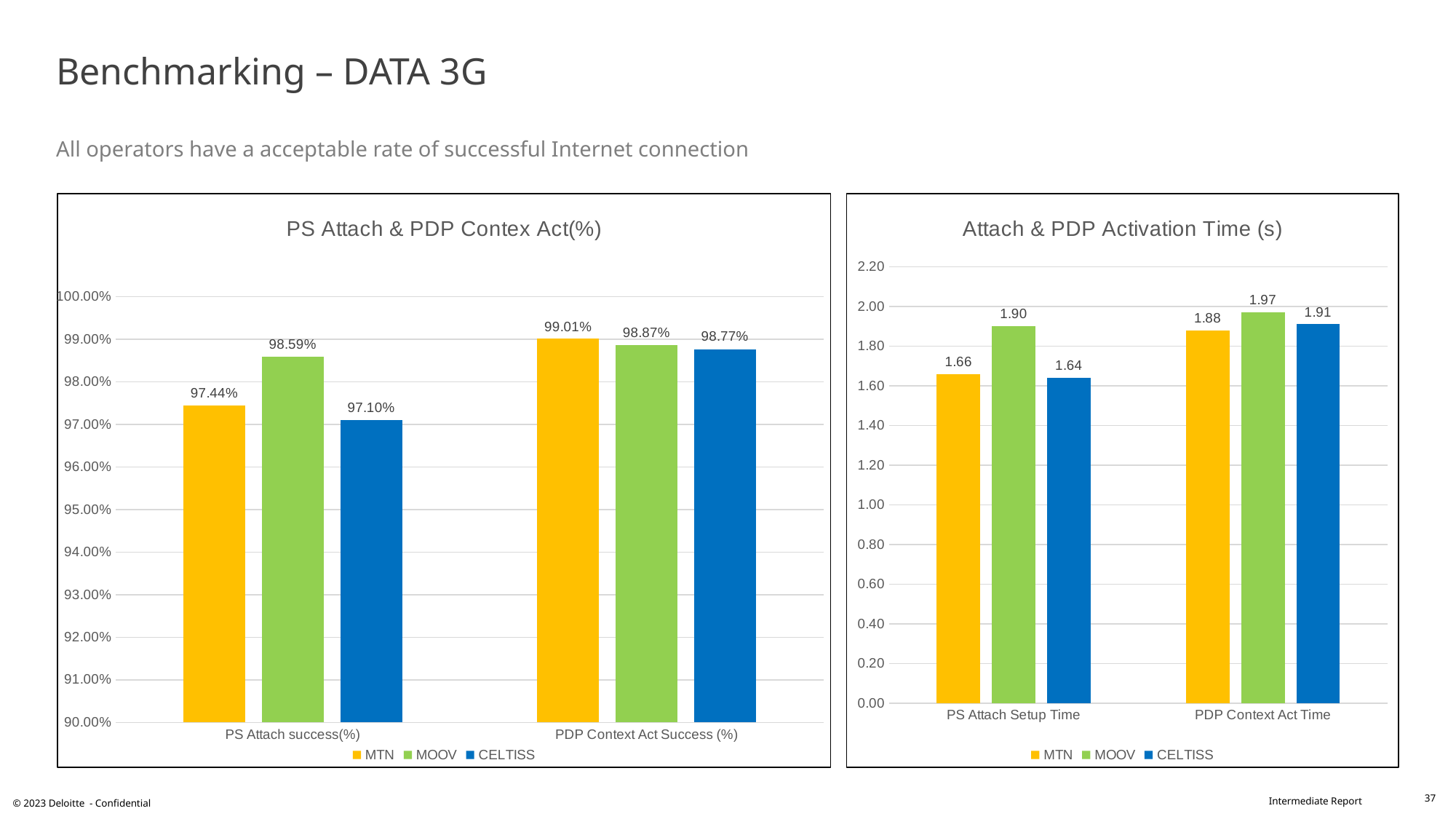
In the 'PS Attach & PDP Contex Act(%)' chart, which operator has the lowest PS Attach success rate? CELTISS In the 'Attach & PDP Activation Time (s)' chart, which operator has the lowest PS Attach Setup Time? CELTISS In the 'Attach & PDP Activation Time (s)' chart, what is the PS Attach Setup Time for MOOV? 1.90 In the 'PS Attach & PDP Contex Act(%)' chart, what is the difference between MOOV's and CELTISS's PS Attach success rates? 1.49% In the 'Attach & PDP Activation Time (s)' chart, what is the difference between MOOV's and MTN's PDP Context Act Time? 0.09 In the 'PS Attach & PDP Contex Act(%)' chart, which operator has the highest PS Attach success rate? MOOV In the 'Attach & PDP Activation Time (s)' chart, is the PDP Context Act Time for MOOV greater or less than 2.00? less In the 'PS Attach & PDP Contex Act(%)' chart, how many series does the legend list? 3 In the 'PS Attach & PDP Contex Act(%)' chart, what is the PDP Context Act Success value for CELTISS? 98.77% In the 'Attach & PDP Activation Time (s)' chart, what is the PDP Context Act Time for MTN? 1.88 What type of chart is the 'Attach & PDP Activation Time (s)' chart? Bar chart In the 'PS Attach & PDP Contex Act(%)' chart, what is the PS Attach success value for MTN? 97.44%